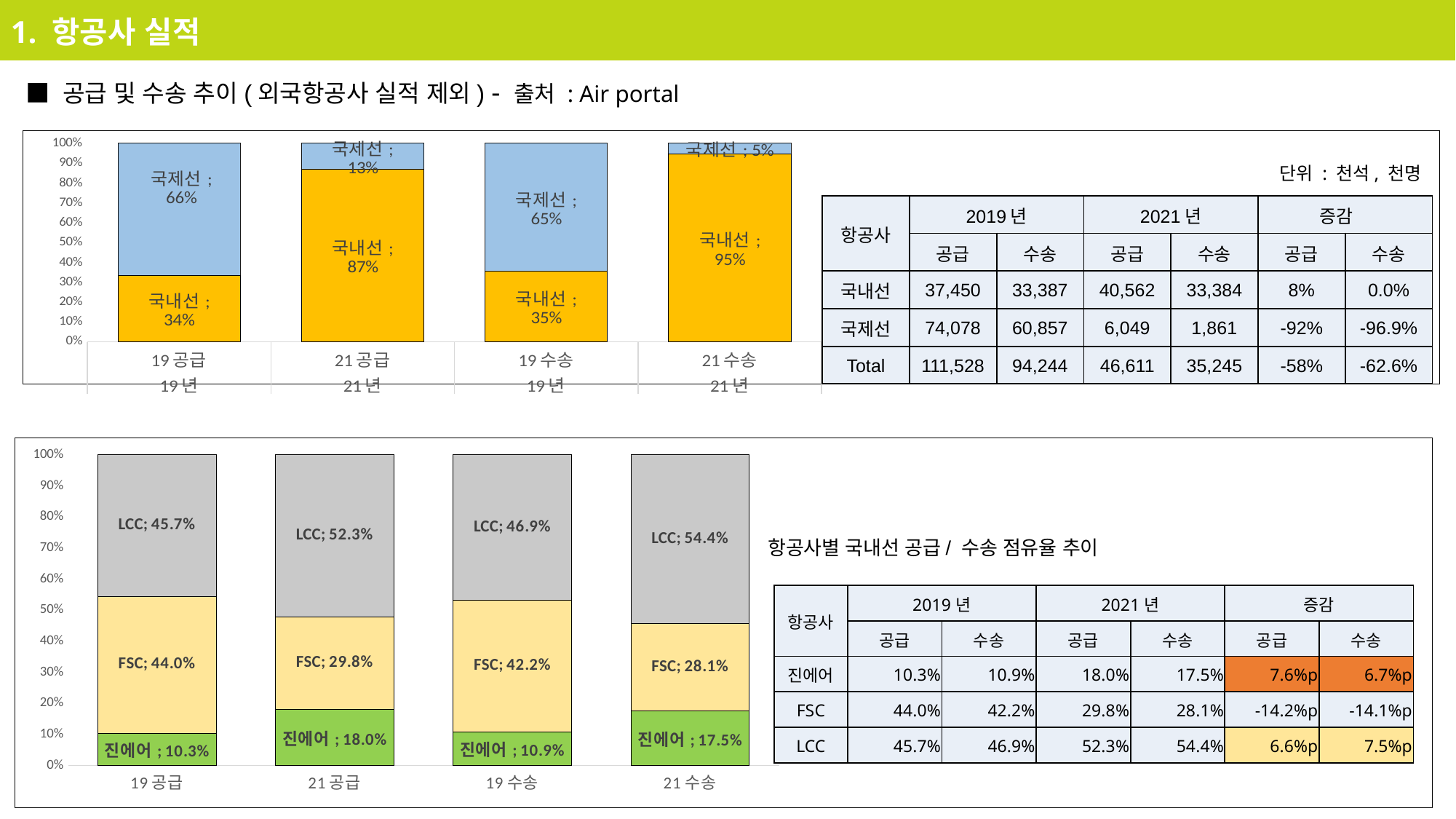
In the top chart, which category has the lowest 국제선 share? 21 수송 In the top chart, what is the 국제선 share for 19 공급? 66% In the bottom chart, is the FSC share for 19 공급 or for 21 공급 larger? 19 공급 In the top chart, how many bars are plotted? 4 In the bottom chart, which category has the lowest FSC share? 21 수송 In the top chart, what is the difference between the 국내선 share for 21 공급 and for 19 공급? 53% What kind of chart is the bottom chart? Stacked bar chart In the bottom chart, what is the difference between the LCC share for 21 공급 and for 19 공급? 6.6% In the bottom chart, what is the LCC share for 21 수송? 54.4% In the top chart, which category has the highest 국내선 share? 21 수송 In the bottom chart, what is the 진에어 share for 21 공급? 18.0% In the top chart, what is the 국내선 share for 21 수송? 95%